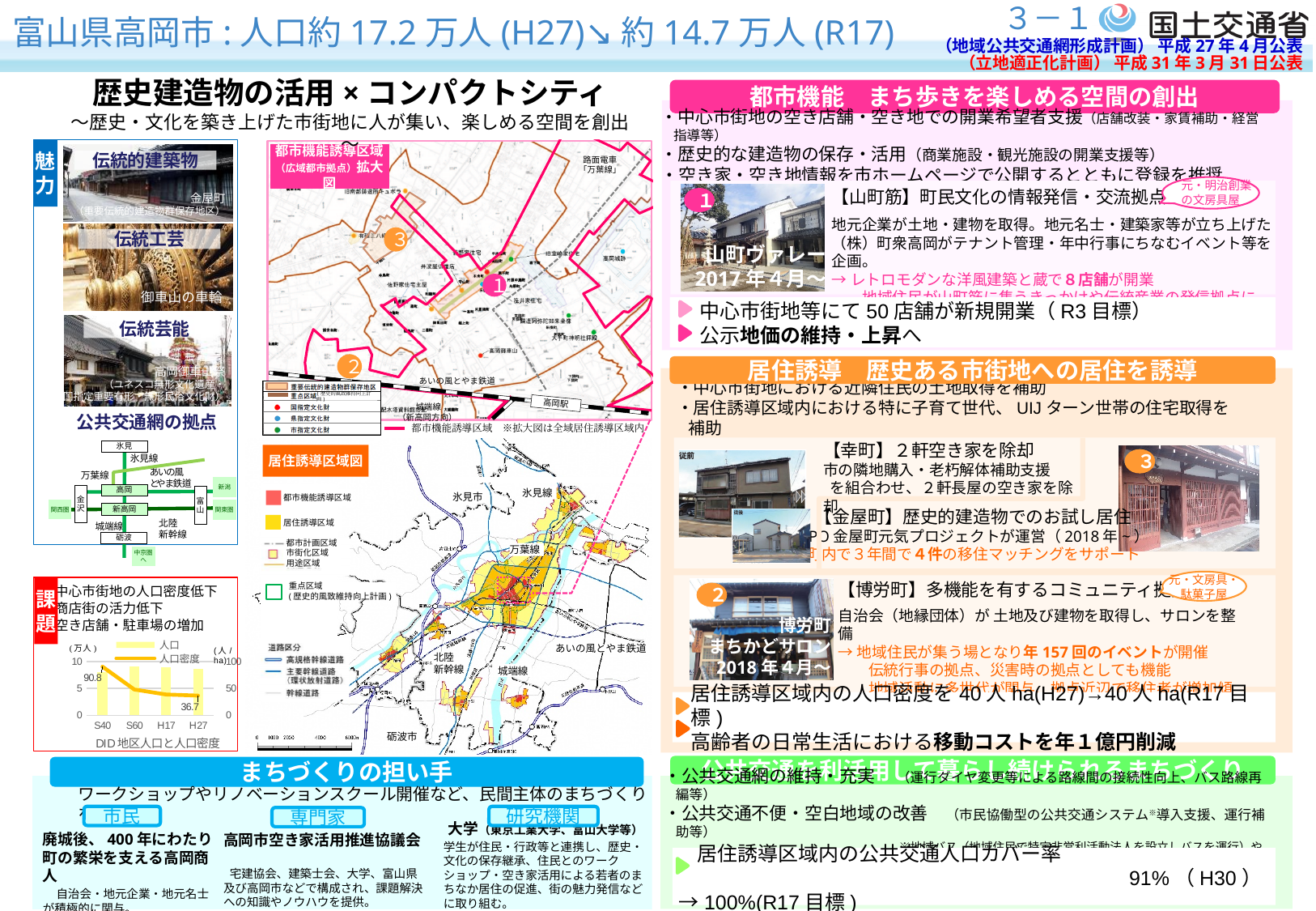
In the 'DID地区人口と人口密度' chart, what is the 人口密度 value for S40? 90.8 In the 'DID地区人口と人口密度' chart, how many series does the legend list? 2 In the 'DID地区人口と人口密度' chart, what are the two legend entries? 人口 and 人口密度 In the 'DID地区人口と人口密度' chart, in which category is 人口密度 highest? S40 In the 'DID地区人口と人口密度' chart, what is the 人口密度 value for H27? 36.7 In the 'DID地区人口と人口密度' chart, which is larger: the 人口密度 for S40 or for H27? S40 In the 'DID地区人口と人口密度' chart, what unit is shown on the right-hand axis? 人/ha In the 'DID地区人口と人口密度' chart, what is the difference between the 人口密度 values for S40 and H27? 54.1 In the 'DID地区人口と人口密度' chart, in which category is 人口密度 lowest? H27 What kind of chart is the 'DID地区人口と人口密度' chart at the bottom left of the slide? A combined bar and line chart In the 'DID地区人口と人口密度' chart, does the 人口密度 line rise or fall from S40 to H27? Fall In the 'DID地区人口と人口密度' chart, how many categories are shown on the x axis? 4